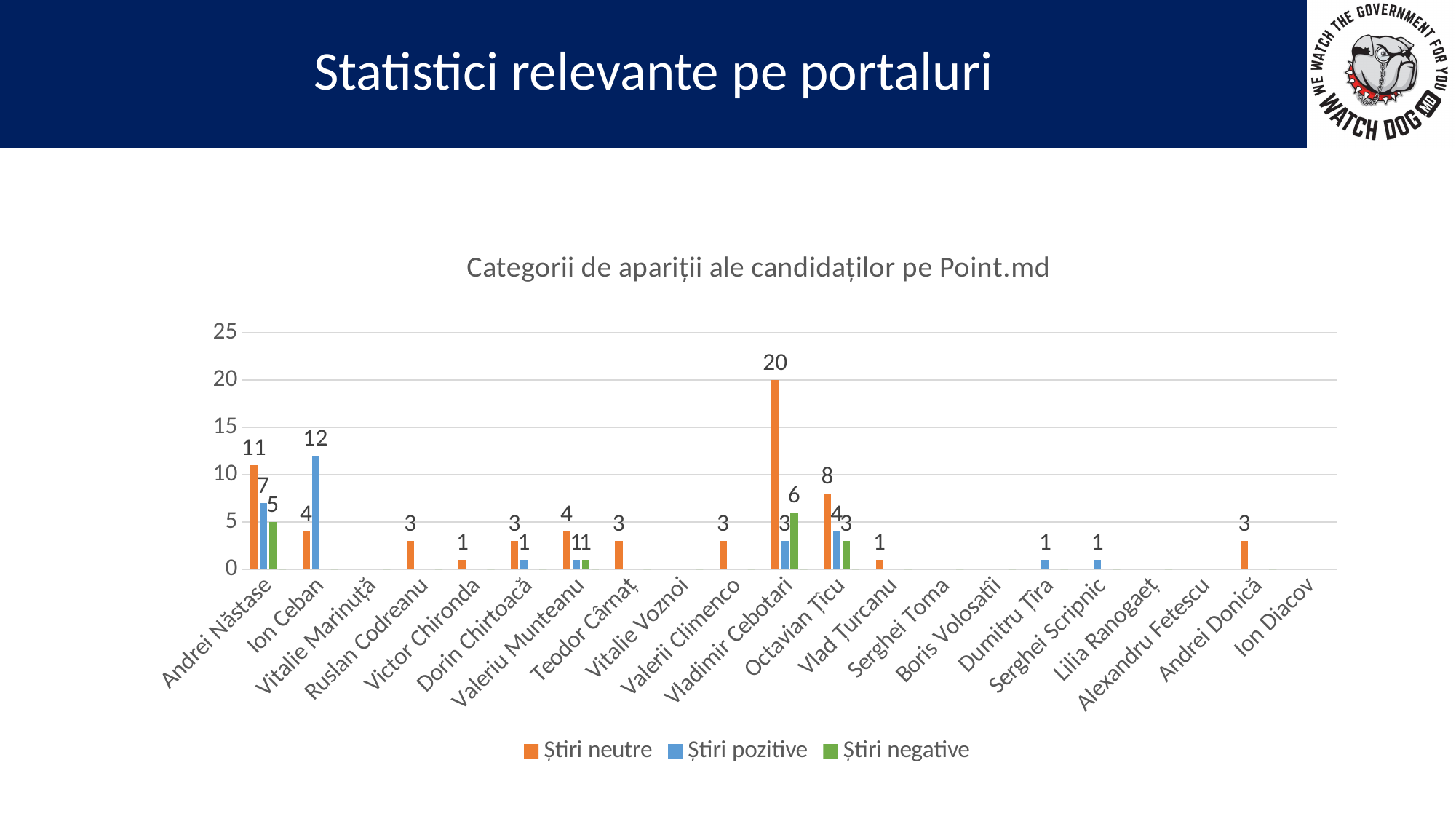
What is the title of the chart? Categorii de apariții ale candidaților pe Point.md What is the value of Știri pozitive for Ion Ceban? 12 How many series does the legend list? 3 What is the value of Știri neutre for Vladimir Cebotari? 20 What kind of chart is shown on the slide? Bar chart How many candidates are shown on the x axis? 21 Which is larger: Știri neutre for Octavian Țîcu or Știri pozitive for Andrei Năstase? Octavian Țîcu's Știri neutre What is the total of Știri neutre, Știri pozitive and Știri negative for Octavian Țîcu? 15 What is the difference between Știri neutre for Vladimir Cebotari and Știri neutre for Andrei Năstase? 9 Which candidate has the highest value for Știri pozitive? Ion Ceban What is the value of Știri negative for Andrei Năstase? 5 Which candidate has the highest value for Știri neutre? Vladimir Cebotari